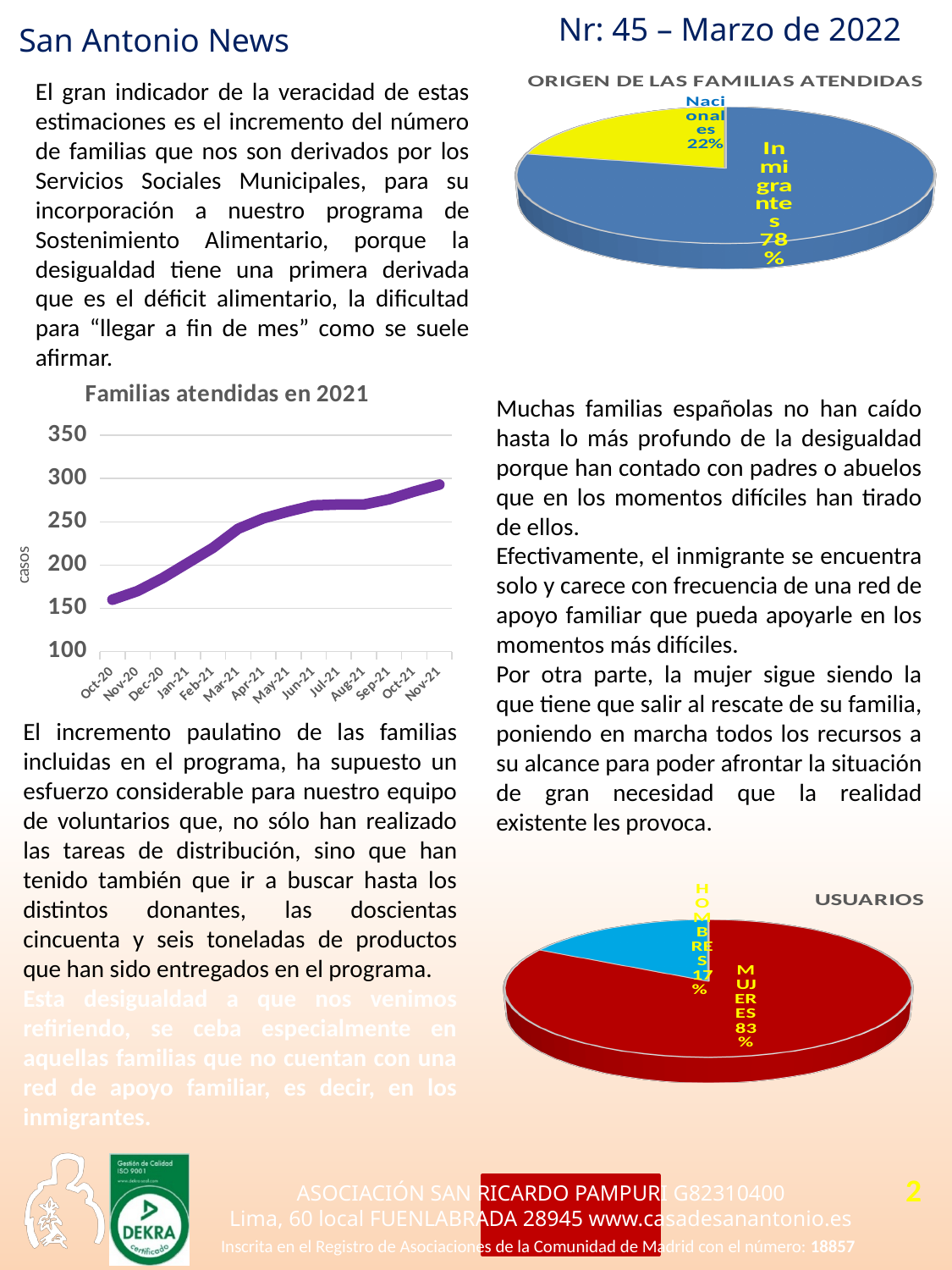
In the pie chart titled 'ORIGEN DE LAS FAMILIAS ATENDIDAS', which slice is larger, Inmigrantes or Nacionales? Inmigrantes In the pie chart titled 'USUARIOS', which slice is the smallest? Hombres In the chart 'Familias atendidas en 2021', do the values rise or fall from Oct-20 to Nov-21? Rise In the pie chart titled 'USUARIOS', what share is labelled for Hombres? 17% How many months are shown on the x axis of the chart 'Familias atendidas en 2021'? 14 In the pie chart titled 'ORIGEN DE LAS FAMILIAS ATENDIDAS', what share is labelled for Inmigrantes? 78% In the chart 'Familias atendidas en 2021', is the value for Oct-20 greater or less than 200? less In the chart 'Familias atendidas en 2021', is the value for Nov-21 greater or less than 250? greater In the pie chart titled 'ORIGEN DE LAS FAMILIAS ATENDIDAS', what is the difference in percentage points between Inmigrantes and Nacionales? 56 In the pie chart titled 'USUARIOS', what share is labelled for Mujeres? 83% What kind of chart is 'Familias atendidas en 2021'? Line chart